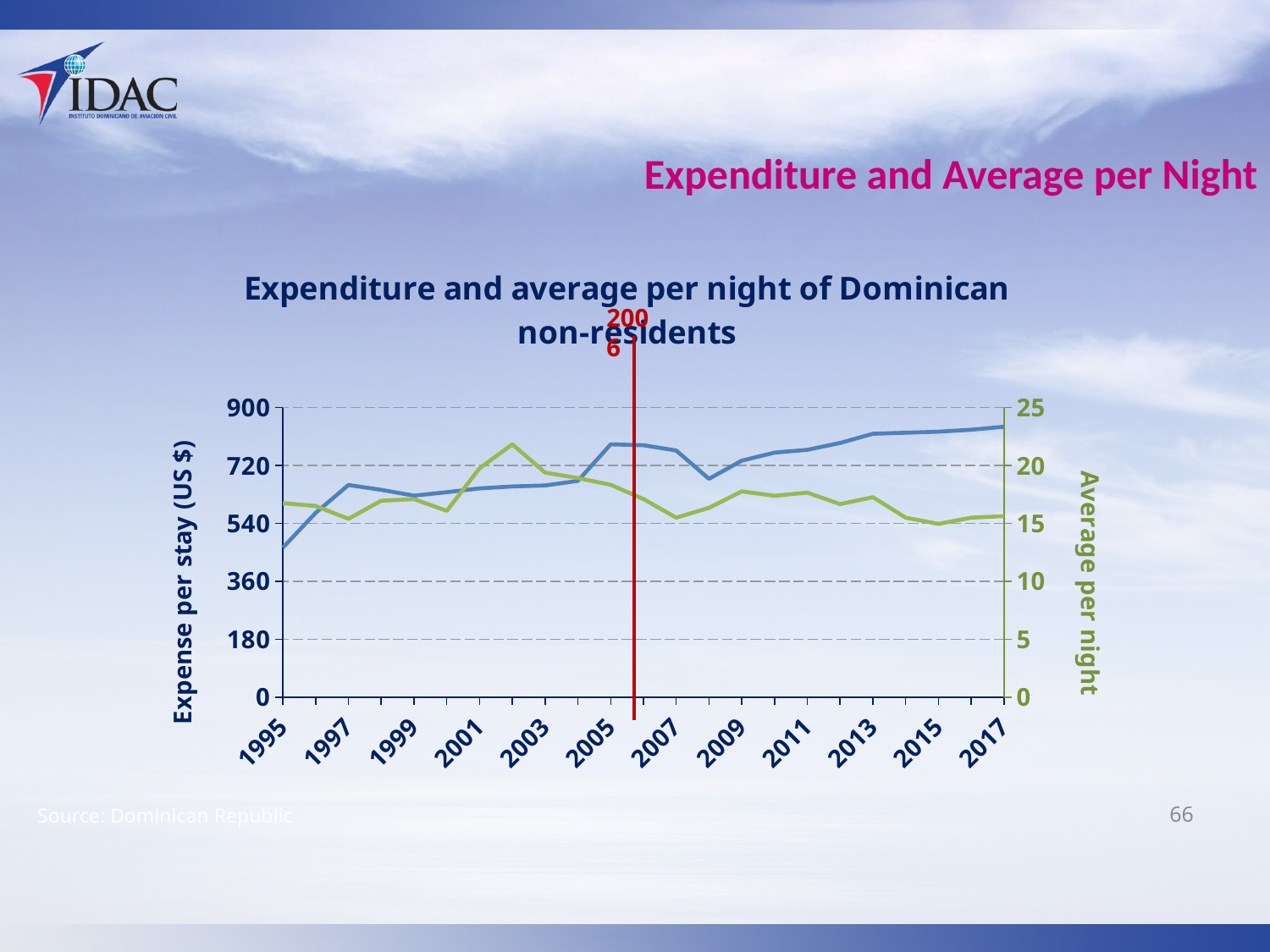
Is the Average per night value for 2002 greater or less than 20? greater What is the label of the left vertical axis? Expense per stay (US $) Is the Expense per stay value for 1995 greater or less than 540? less Does the Expense per stay line generally rise or fall from 1995 to 2017? rise What is the title of the chart? Expenditure and average per night of Dominican non-residents In which year is the Expense per stay line at its highest? 2017 What kind of chart is shown on the slide? line chart In which year does the Average per night line reach its highest point? 2002 Which year has the larger Expense per stay value, 1995 or 2017? 2017 Is the Expense per stay value for 2017 greater or less than 720? greater In which year is the Expense per stay line at its lowest? 1995